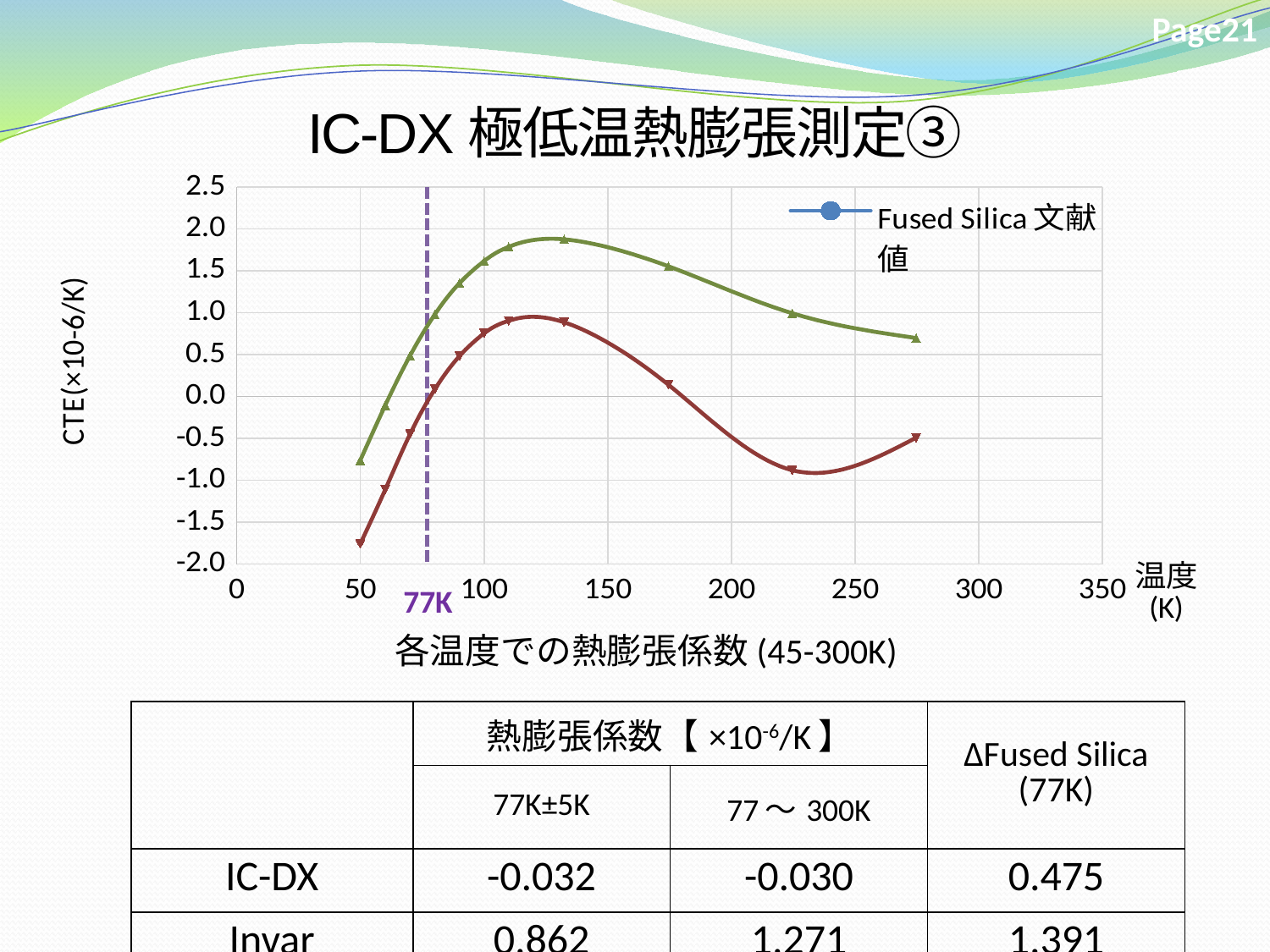
Is the value of the lower (red) line at 225 K greater or less than -0.5? less What series name is shown in the chart's legend? Fused Silica 文献値 Does the green line rise or fall between 50 K and 125 K? rise Is the value of the lower (red) line at 50 K greater or less than -1.5? less What kind of chart is shown on the slide? line chart Does the green line rise or fall between 150 K and 275 K? fall Is the peak value of the lower (red) line greater or less than 1.5? less What temperature does the dashed vertical line in the chart mark? 77K Does the red line rise or fall between 150 K and 225 K? fall At 275 K, which line has the higher value, the green line or the red line? the green line